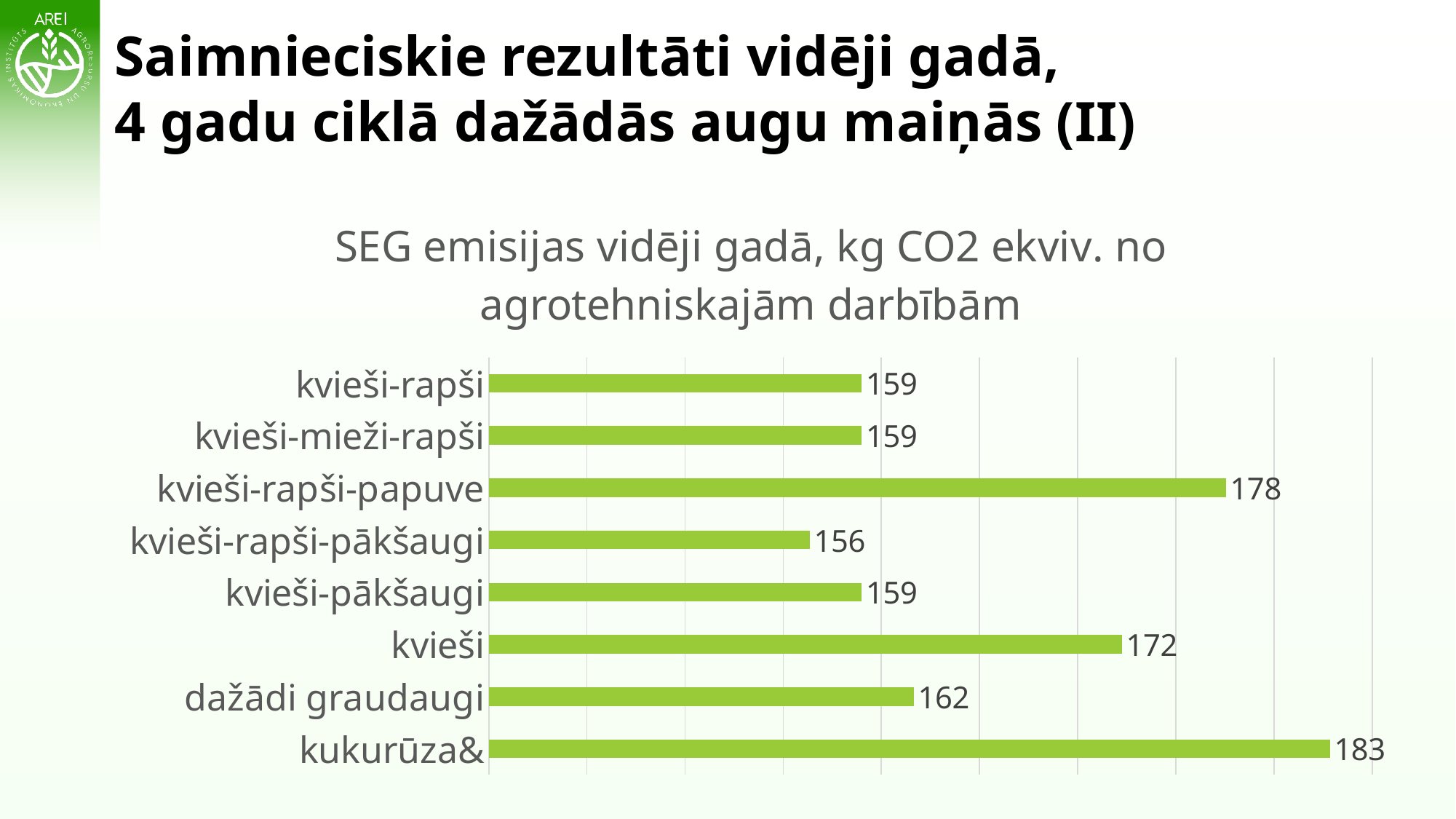
What is the title of the chart? SEG emisijas vidēji gadā, kg CO2 ekviv. no agrotehniskajām darbībām What is the value for kvieši-rapši-papuve? 178 What is the value for dažādi graudaugi? 162 What is the value for kvieši-rapši-pākšaugi? 156 Which is larger, the value for kvieši or the value for kvieši-pākšaugi? kvieši Which category has the lowest value? kvieši-rapši-pākšaugi Which category has the highest value? kukurūza& What is the difference between the values for kvieši and dažādi graudaugi? 10 What kind of chart is shown on the slide? bar chart How many categories are shown in the chart? 8 What is the difference between the values for kukurūza& and kvieši-rapši-pākšaugi? 27 What is the value for kukurūza&? 183